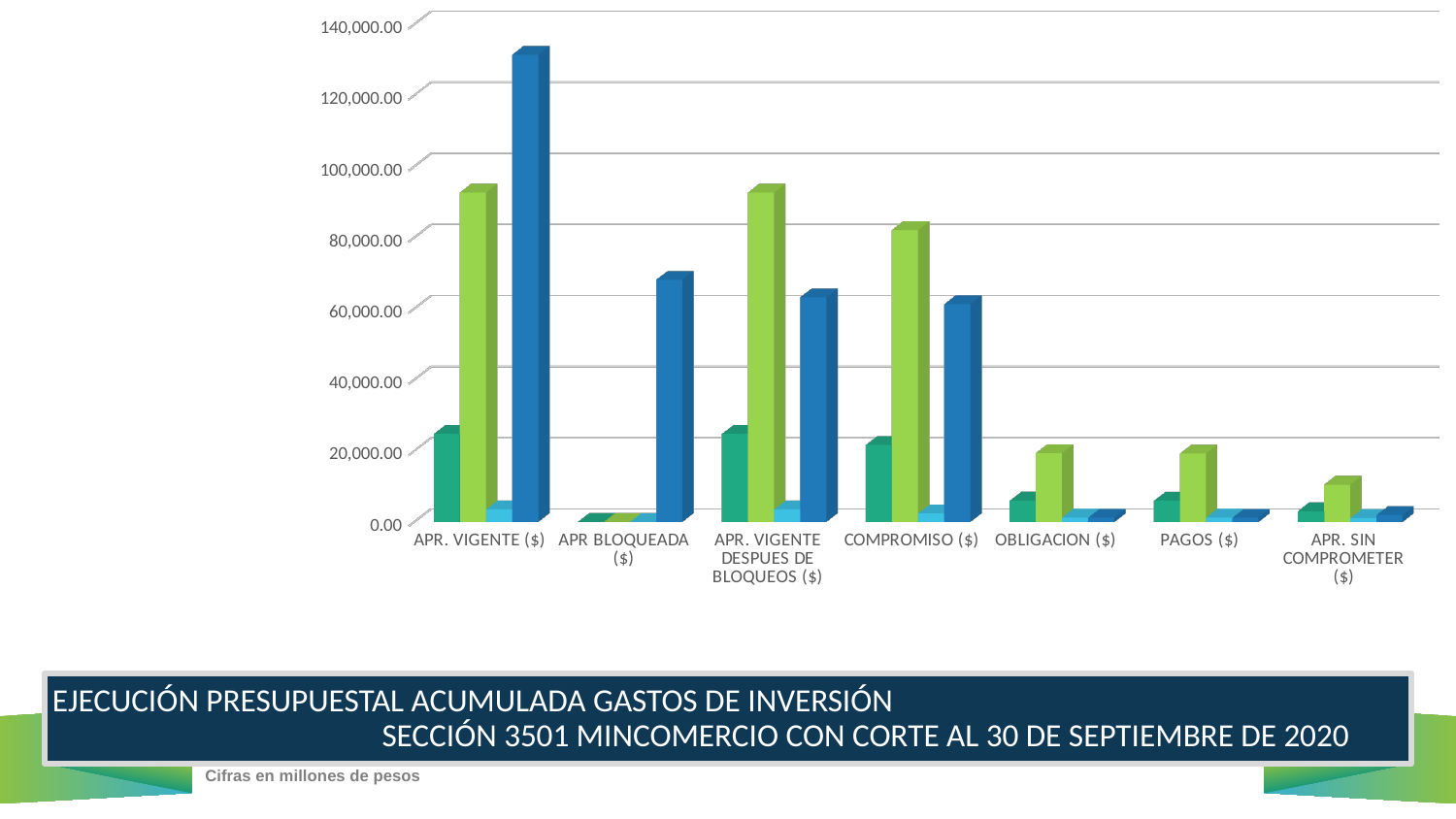
What kind of chart is shown on the slide? Bar chart According to the note below the chart, in what units are the figures expressed? Millones de pesos Which has the larger dark blue bar, APR. VIGENTE ($) or APR BLOQUEADA ($)? APR. VIGENTE ($) How many categories are shown on the x axis of the chart? 7 Is the lime green bar for OBLIGACION ($) greater or less than 40,000.00? less Is the dark blue bar for APR. VIGENTE DESPUES DE BLOQUEOS ($) greater or less than 80,000.00? less Is the dark blue bar for APR. VIGENTE ($) greater or less than 120,000.00? greater What is the highest value shown on the y axis of the chart? 140,000.00 Which category has the tallest bar in the chart? APR. VIGENTE ($)